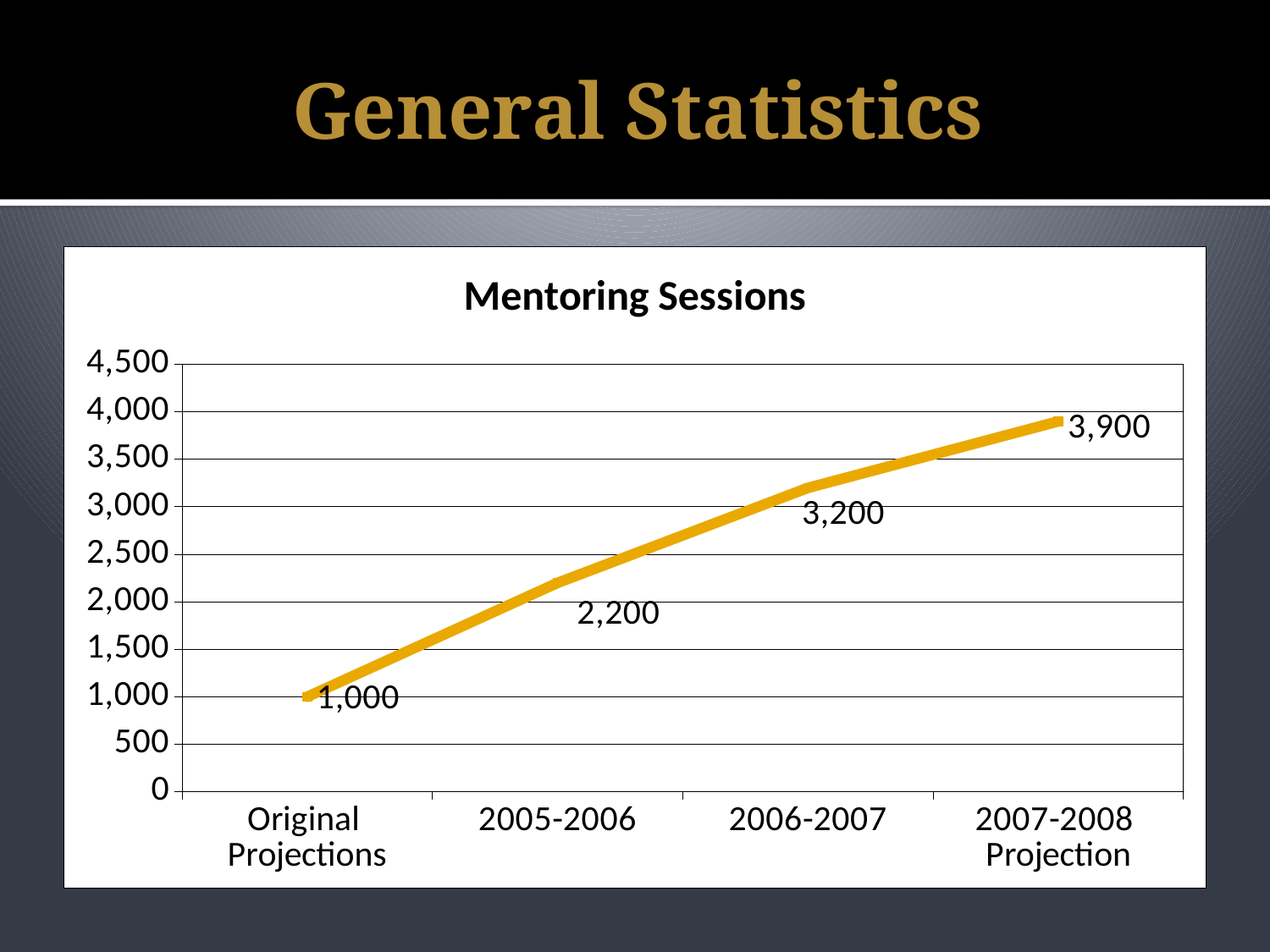
What is the value for 2005-2006 in the Mentoring Sessions chart? 2,200 Which category has the highest value in the Mentoring Sessions chart? 2007-2008 Projection How many data points are plotted in the Mentoring Sessions chart? 4 What is the value for Original Projections in the Mentoring Sessions chart? 1,000 Do the values in the Mentoring Sessions chart rise or fall from left to right along the x axis? Rise What is the value for 2007-2008 Projection in the Mentoring Sessions chart? 3,900 What kind of chart is the Mentoring Sessions chart? Line chart Which is larger in the Mentoring Sessions chart, the value for 2005-2006 or the value for 2006-2007? 2006-2007 What is the difference between the values for 2006-2007 and 2005-2006 in the Mentoring Sessions chart? 1,000 Which category has the lowest value in the Mentoring Sessions chart? Original Projections What is the value for 2006-2007 in the Mentoring Sessions chart? 3,200 What is the difference between the 2007-2008 Projection and the Original Projections in the Mentoring Sessions chart? 2,900